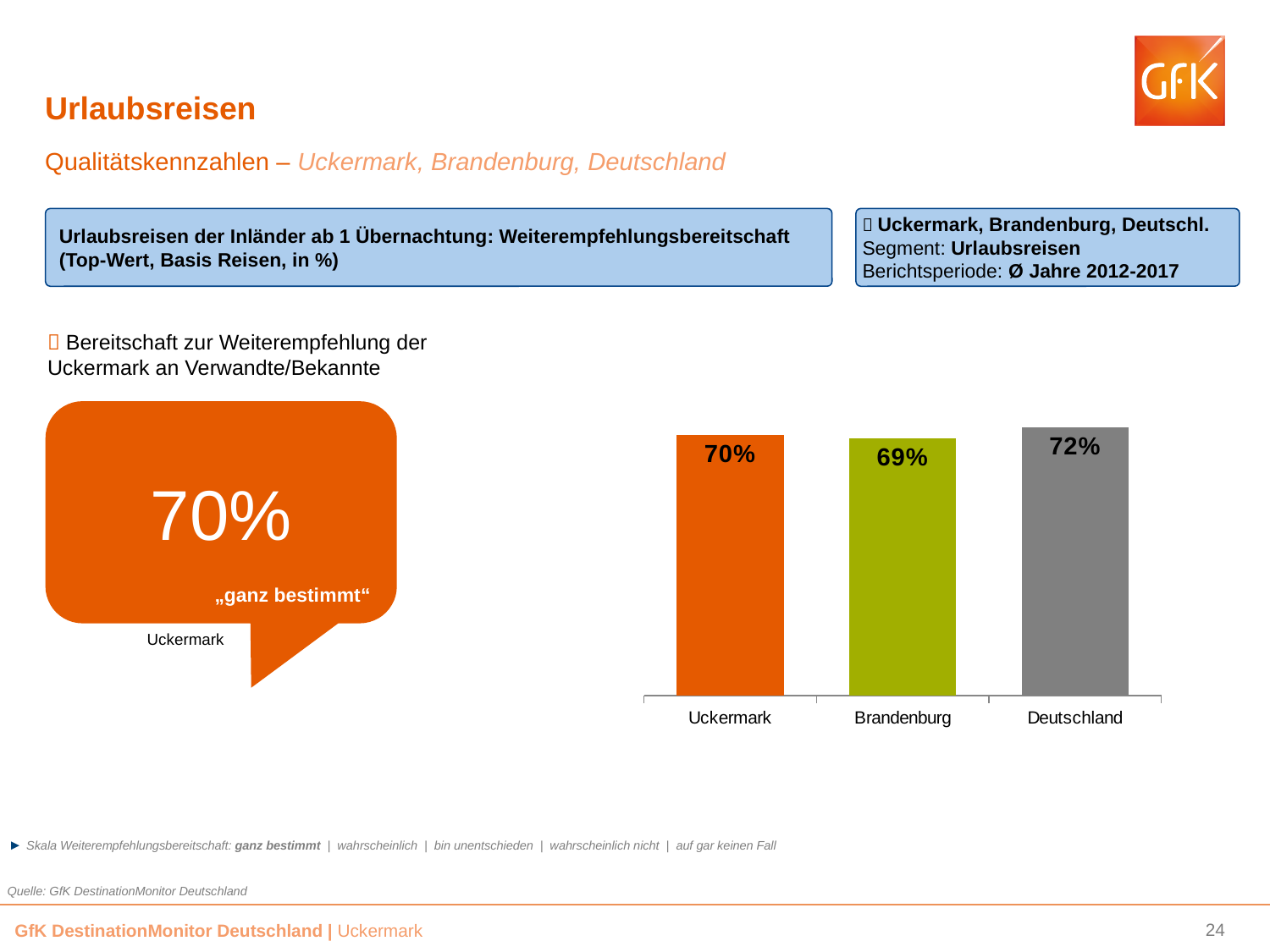
How many categories are shown in the bar chart? 3 Which category has the lowest value in the bar chart? Brandenburg Which is larger in the bar chart, the value for Deutschland or the value for Brandenburg? Deutschland What is the difference between the values for Deutschland and Uckermark in the bar chart? 2 percentage points Which category has the highest value in the bar chart? Deutschland What kind of chart is shown on the slide? Bar chart What value is shown in the large orange speech bubble on the left? 70% What is the value for Uckermark in the bar chart? 70% What is the difference between the values for Uckermark and Brandenburg in the bar chart? 1 percentage point What is the value for Brandenburg in the bar chart? 69% What colour is the bar for Brandenburg in the bar chart? Green What is the value for Deutschland in the bar chart? 72%